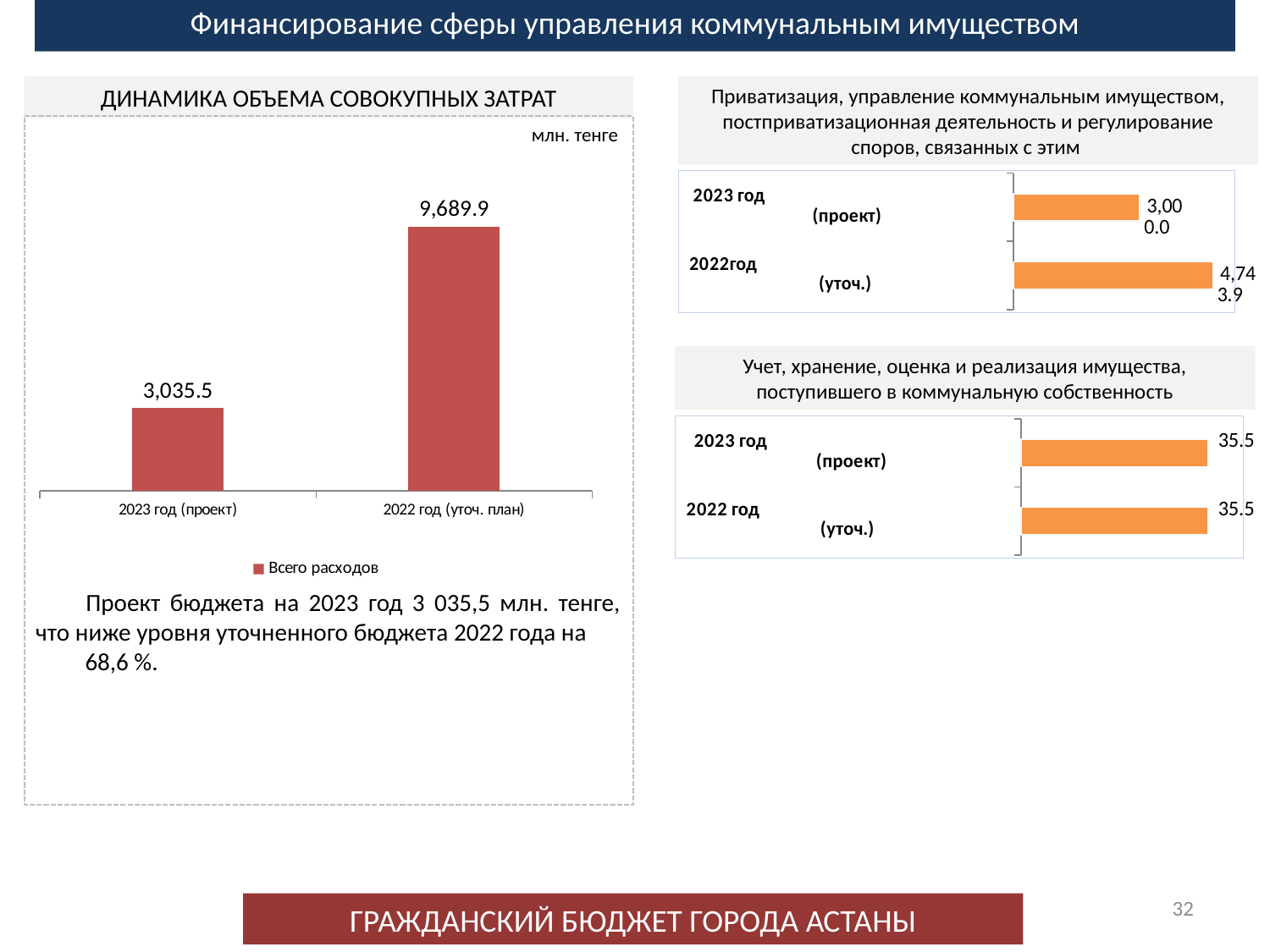
In the chart titled 'Приватизация, управление коммунальным имуществом, постприватизационная деятельность и регулирование споров, связанных с этим', which is larger: the value for 2023 год (проект) or the value for 2022год (уточ.)? 2022год (уточ.) In the chart titled 'Учет, хранение, оценка и реализация имущества, поступившего в коммунальную собственность', what is the value for 2022 год (уточ.)? 35.5 In the chart titled 'ДИНАМИКА ОБЪЕМА СОВОКУПНЫХ ЗАТРАТ', what unit is indicated in the top right corner of the chart? млн. тенге In the chart titled 'ДИНАМИКА ОБЪЕМА СОВОКУПНЫХ ЗАТРАТ', what kind of chart is shown? bar chart In the chart titled 'ДИНАМИКА ОБЪЕМА СОВОКУПНЫХ ЗАТРАТ', which category has the highest value? 2022 год (уточ. план) In the chart titled 'ДИНАМИКА ОБЪЕМА СОВОКУПНЫХ ЗАТРАТ', what series does the legend list? Всего расходов In the chart titled 'ДИНАМИКА ОБЪЕМА СОВОКУПНЫХ ЗАТРАТ', what is the difference between the 2022 год (уточ. план) value and the 2023 год (проект) value? 6,654.4 In the chart titled 'Учет, хранение, оценка и реализация имущества, поступившего в коммунальную собственность', what is the difference between the 2023 год (проект) value and the 2022 год (уточ.) value? 0 In the chart titled 'Приватизация, управление коммунальным имуществом, постприватизационная деятельность и регулирование споров, связанных с этим', how many bars are shown? 2 In the chart titled 'Учет, хранение, оценка и реализация имущества, поступившего в коммунальную собственность', what is the value for 2023 год (проект)? 35.5 In the chart titled 'ДИНАМИКА ОБЪЕМА СОВОКУПНЫХ ЗАТРАТ', what is the value for 2022 год (уточ. план)? 9,689.9 In the chart titled 'ДИНАМИКА ОБЪЕМА СОВОКУПНЫХ ЗАТРАТ', what is the value for 2023 год (проект)? 3,035.5